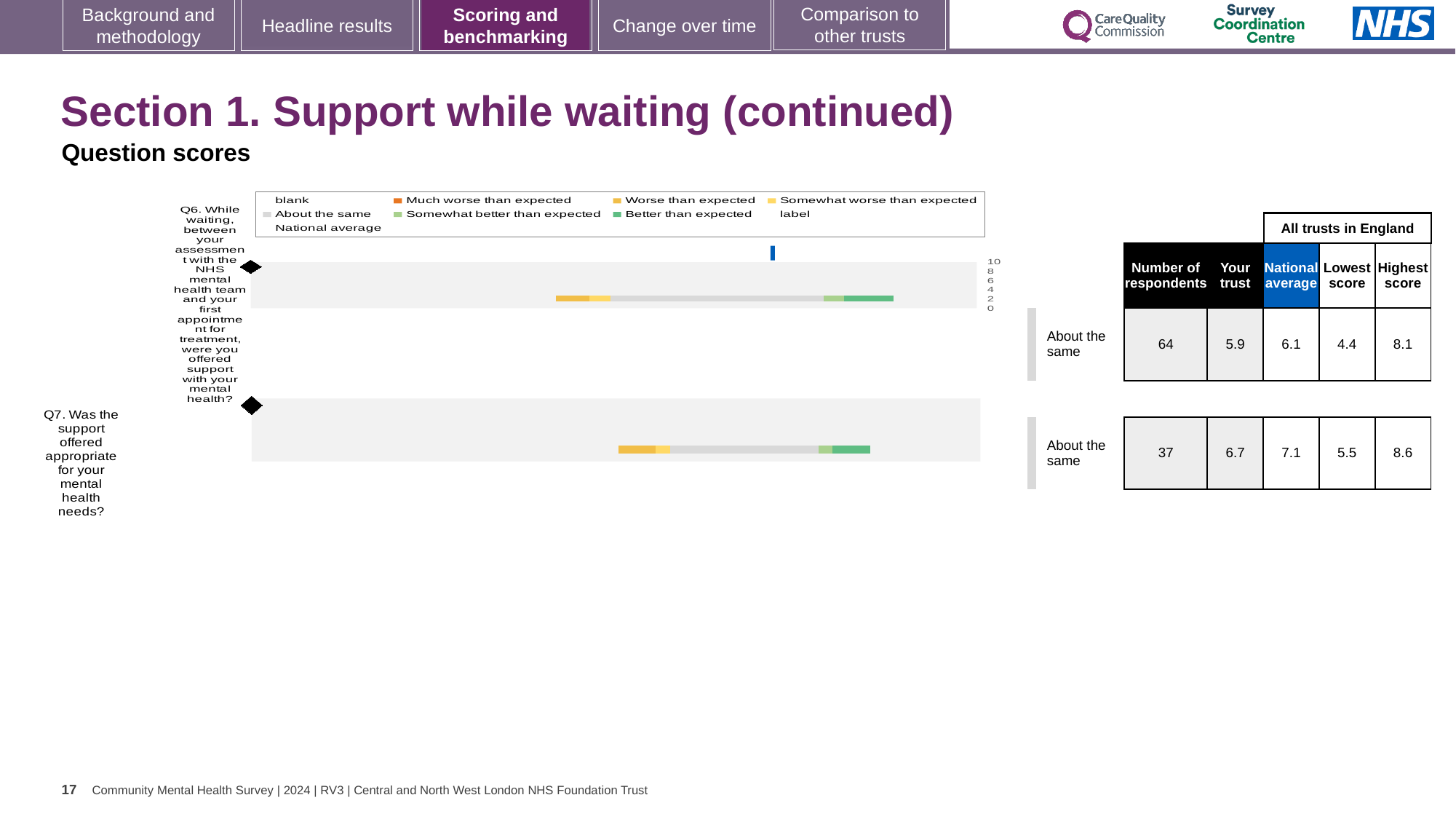
What is the difference between the highest and lowest scores for Q7? 3.1 How many respondents answered Q6? 64 What kind of chart is used to show the question scores on this slide? bar chart What is the highest score among all trusts in England for Q6? 8.1 How much higher is the national average than the trust's score for Q6? 0.2 What benchmark category is shown for both Q6 and Q7? About the same How many questions (bars) are plotted in the chart? 2 What is the 'Your trust' score for Q6 (support with mental health while waiting)? 5.9 What is the 'Your trust' score for Q7 (was the support offered appropriate)? 6.7 What is the national average score for Q7? 7.1 Which question has the higher 'Your trust' score, Q6 or Q7? Q7 What colour represents 'Better than expected' in the legend? green